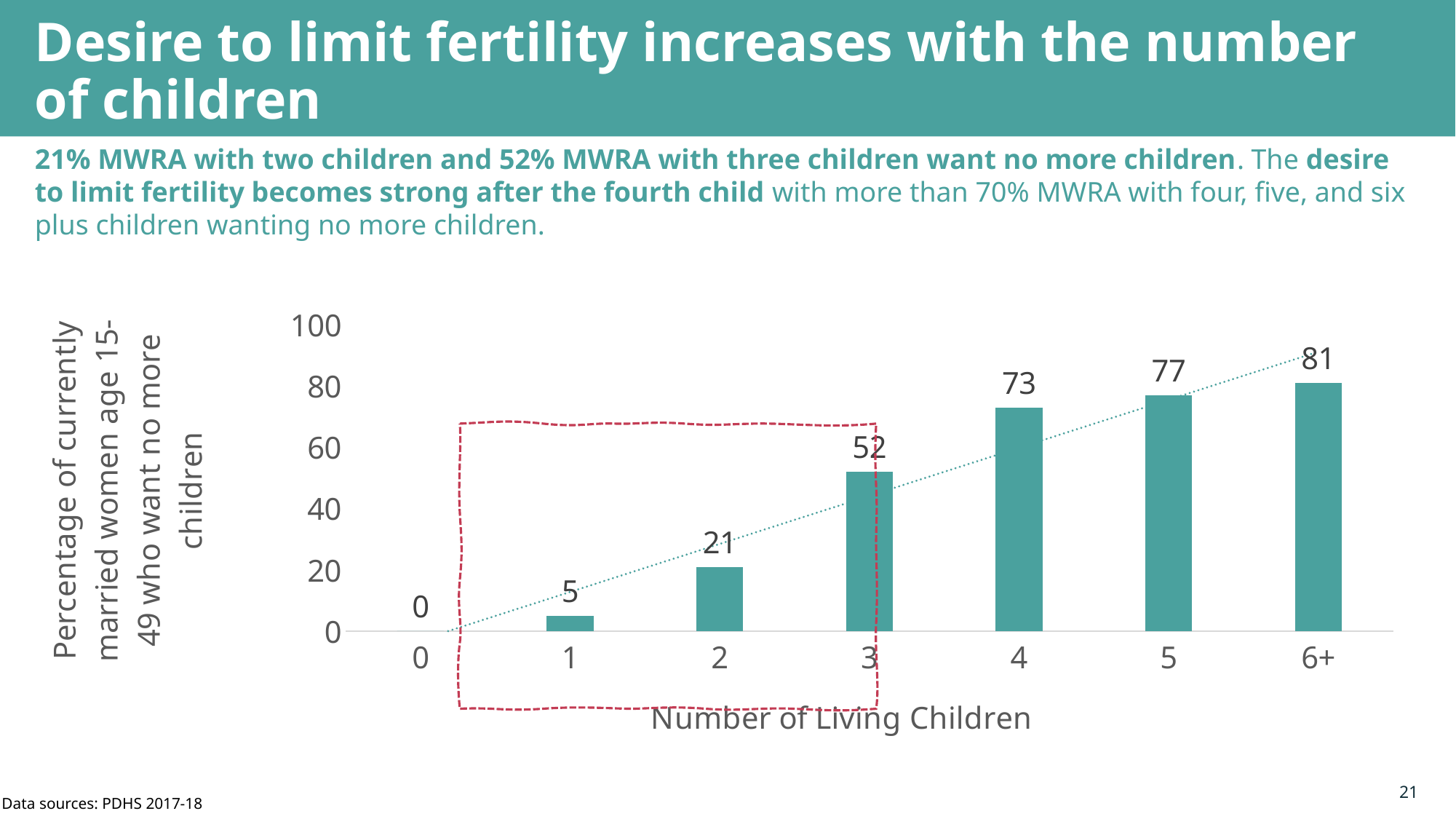
Which number of living children has the highest value? 6+ What is the x-axis title of the chart? Number of Living Children What is the difference between the values for 4 and 3 living children? 21 What is the value for 1 living child? 5 What is the difference between the values for 6+ and 5 living children? 4 What is the value for 6+ living children? 81 Which is larger, the value for 2 living children or the value for 5 living children? 5 living children What is the value for 3 living children? 52 Do the values rise or fall as the number of living children increases? rise What kind of chart is this? bar chart How many categories are shown on the x axis? 7 Which number of living children has the lowest value? 0